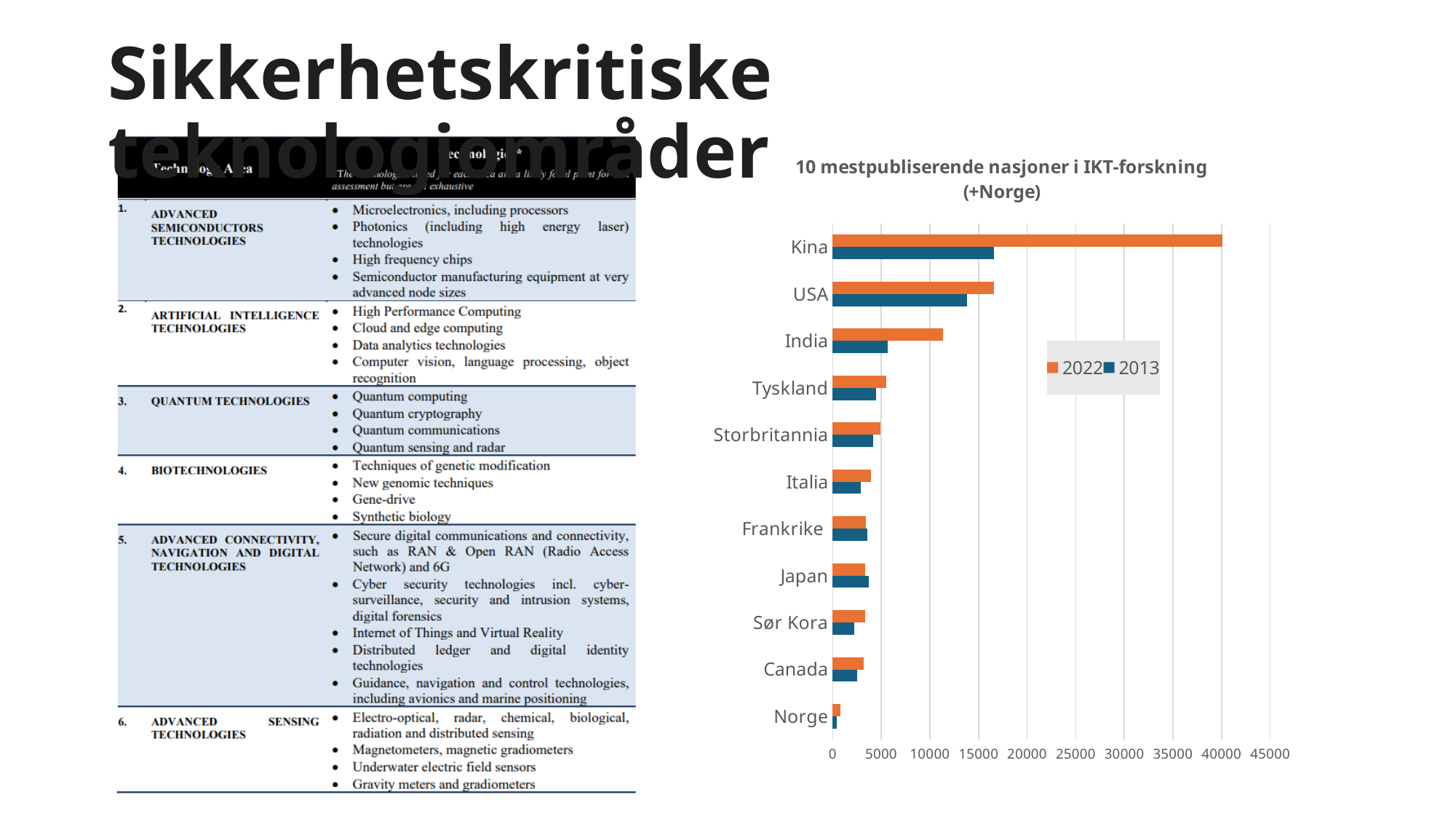
Is the 2022 value for Norge greater or less than 5000? less Is the 2022 value for India greater or less than 10000? greater Which country has the lowest value for 2022? Norge What is the title of the chart? 10 mestpubliserende nasjoner i IKT-forskning (+Norge) Is the 2013 value for USA greater or less than 15000? less How many series does the chart's legend list? 2 How many countries are shown on the chart? 11 What kind of chart is shown on the slide? bar chart Which country has the highest value for 2022? Kina Which colour represents the 2013 series in the chart? blue Which is larger for India: the 2022 value or the 2013 value? 2022